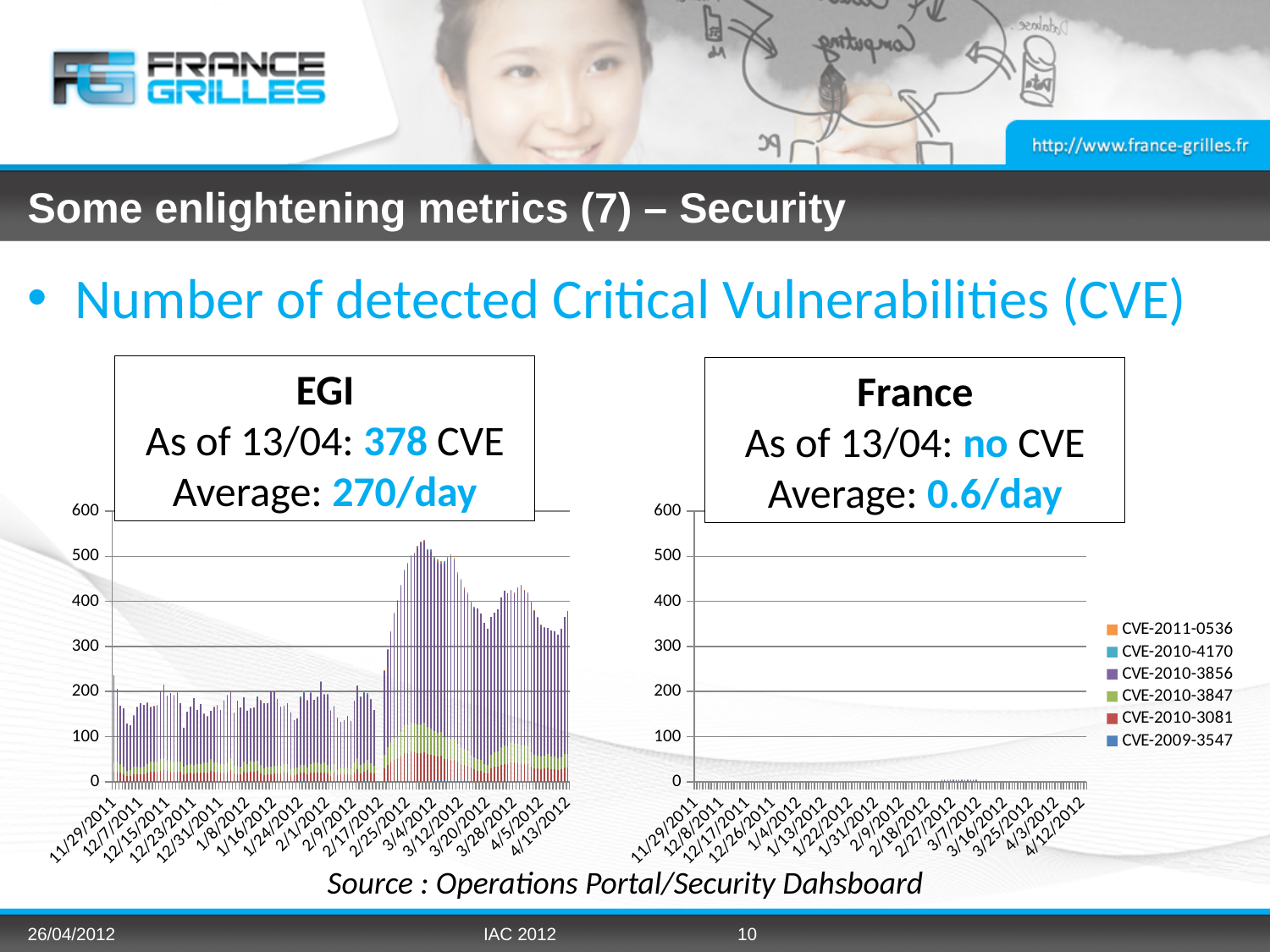
According to the EGI chart's annotation, how many CVE were detected as of 13/04? 378 CVE Which CVE is listed first (at the top) in the legend? CVE-2011-0536 In the EGI chart, is the value at 12/15/2011 greater or less than 300? less In the EGI chart, do the values rise or fall between 2/17/2012 and 3/4/2012? rise In the France chart, is the value at 2/9/2012 greater or less than 100? less According to the France chart's annotation, how many CVE were detected as of 13/04? no CVE According to the EGI chart's annotation, what is the average number of CVE per day? 270/day How many series does the legend list for the CVE charts? 6 According to the France chart's annotation, what is the average number of CVE per day? 0.6/day Which chart shows higher CVE counts overall, EGI or France? EGI In the EGI chart, is the value around 3/4/2012 greater or less than 400? greater What kind of chart is the EGI chart on the left? bar chart